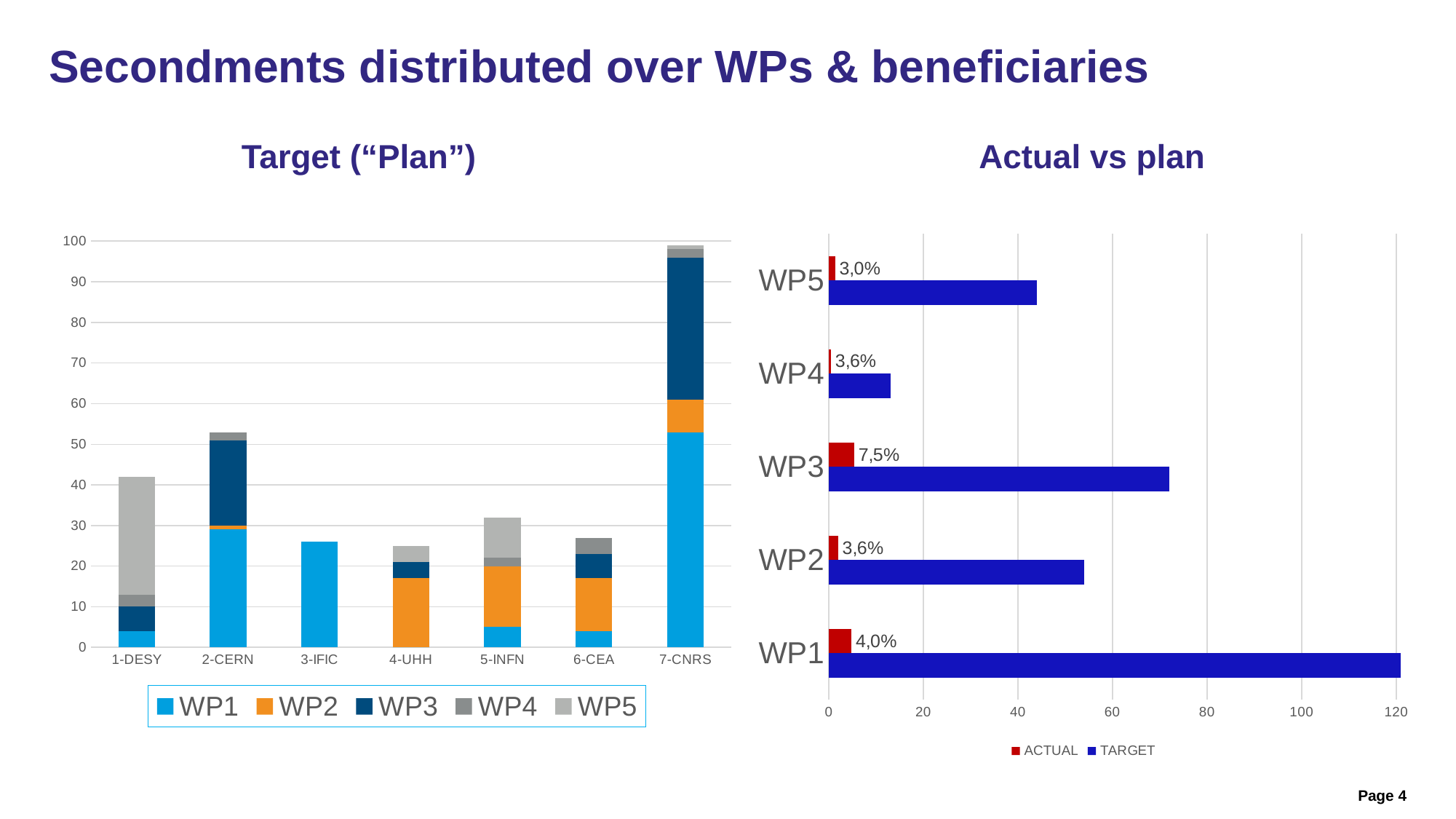
How many beneficiaries are shown on the x axis of the "Target ("Plan")" chart? 7 On the "Target ("Plan")" chart, which beneficiary has the highest total stacked bar? 7-CNRS How many series does the legend of the "Actual vs plan" chart list? 2 On the "Actual vs plan" chart, is the TARGET bar for WP1 greater or less than 100? greater On the "Actual vs plan" chart, is the TARGET bar for WP4 greater or less than 20? less On the "Actual vs plan" chart, what is the ACTUAL value labelled for WP3? 7,5% On the "Actual vs plan" chart, what is the ACTUAL value labelled for WP1? 4,0% On the "Actual vs plan" chart, what is the difference between the labelled ACTUAL percentages of WP3 and WP1? 3,5% On the "Actual vs plan" chart, which WP has the lowest labelled ACTUAL percentage? WP5 What kind of chart is the "Target ("Plan")" chart? Stacked bar chart On the "Actual vs plan" chart, which WP has the highest labelled ACTUAL percentage? WP3 On the "Target ("Plan")" chart, is the total bar for 3-IFIC greater or less than 30? less